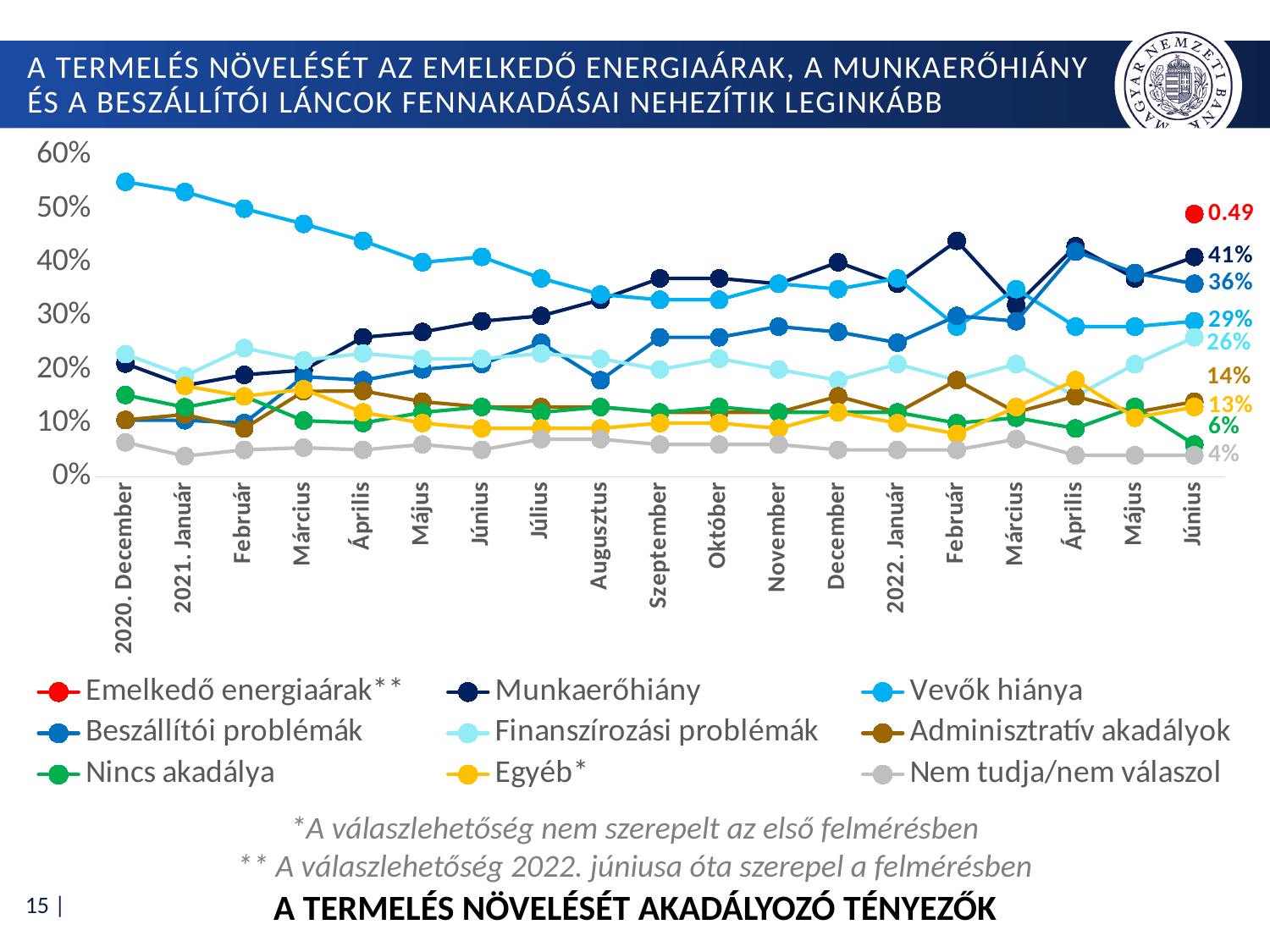
In Június 2022, which is larger: Vevők hiánya or Finanszírozási problémák? Vevők hiánya Which series has the highest value in Június 2022? Emelkedő energiaárak What is the value for Nincs akadálya in Június 2022? 6% How many series does the legend list? 9 What is the value for Munkaerőhiány in Június 2022? 41% What is the value for Beszállítói problémák in Június 2022? 36% What kind of chart is shown on the slide? line chart Is the value for Vevők hiánya in 2020. December greater or less than 50%? greater Does the Vevők hiánya series rise or fall from 2020. December to Június 2022? fall In Június 2022, how many percentage points higher is Munkaerőhiány than Beszállítói problémák? 5 percentage points What value is labelled for Emelkedő energiaárak in Június 2022? 0.49 Which series has the lowest value in Június 2022? Nem tudja/nem válaszol